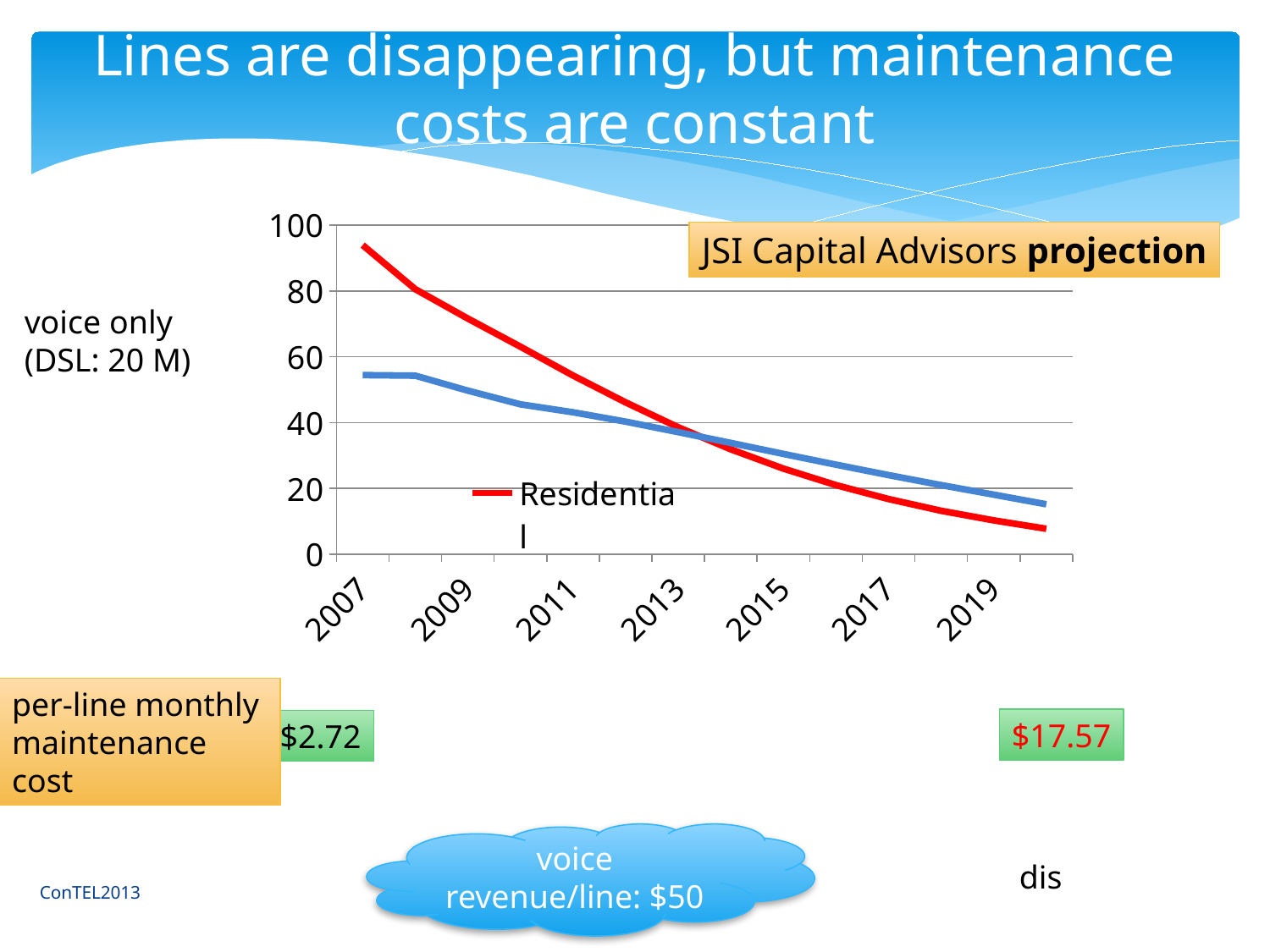
What kind of chart is shown on the slide? line chart Which series is named in the chart's legend? Residential Is the Residential value in 2007 greater or less than 80? greater Is the Residential value at the last point (2020) greater or less than 20? less Does the blue line rise or fall across the years shown? fall How many lines are plotted on the chart? 2 What colour is the Residential line? red In 2019, which line is higher, the red Residential line or the blue line? the blue line In which year does the Residential line reach its highest value? 2007 Is the blue line's value in 2007 greater or less than 60? less In 2007, which line is higher, the red Residential line or the blue line? Residential (red) Does the Residential line rise or fall from 2007 to 2020? fall